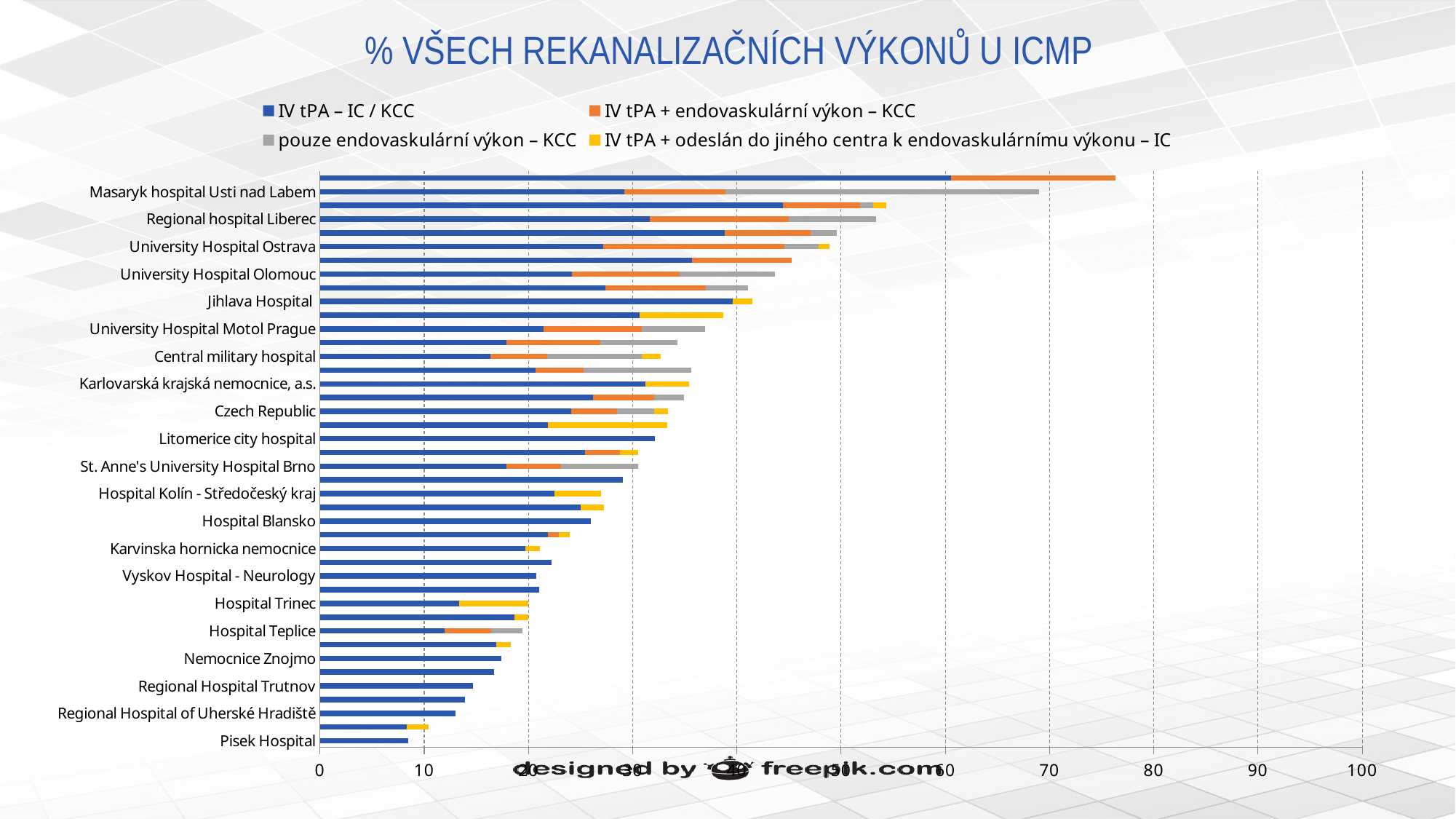
What is the title of the chart? % VŠECH REKANALIZAČNÍCH VÝKONŮ U ICMP How many series does the legend list? 4 Which labelled hospital has the longest total bar? Masaryk hospital Usti nad Labem Do the total bar lengths increase or decrease going from the top of the chart to the bottom? decrease Is the total value for Masaryk hospital Usti nad Labem greater or less than 60? greater Is the total value for Pisek Hospital greater or less than 10? less Which colour represents the series "IV tPA – IC / KCC" in the legend? Blue What kind of chart is shown on the slide? Stacked horizontal bar chart Which has the larger total bar, Regional Hospital Trutnov or Regional hospital Liberec? Regional hospital Liberec Is the total value for Czech Republic greater or less than 40? less Which labelled hospital has the shortest total bar? Pisek Hospital